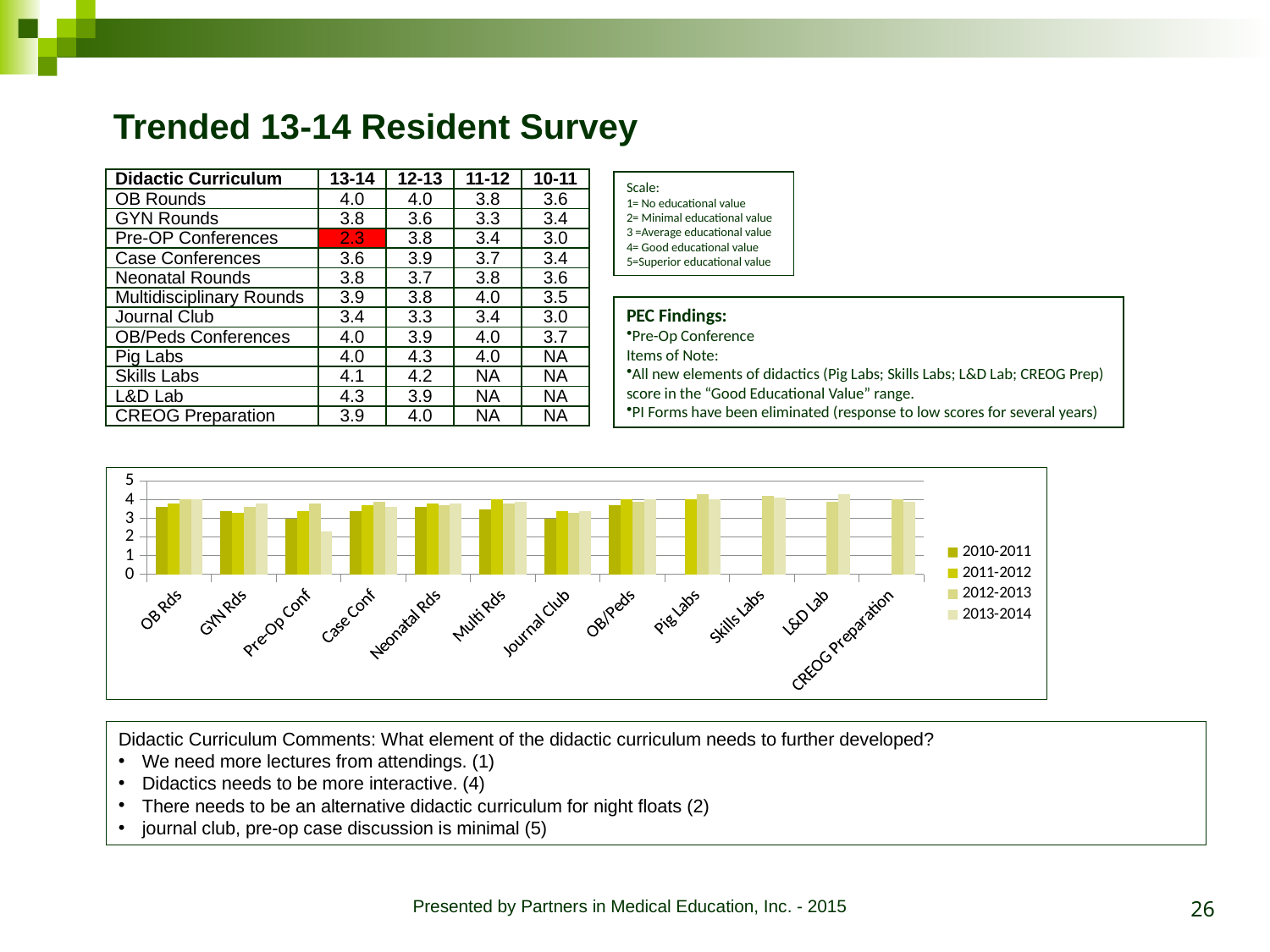
Which series are missing bars for Skills Labs, L&D Lab and CREOG Preparation? 2010-2011 and 2011-2012 What is the 2012-2013 value for Pig Labs (as printed in the table under 12-13)? 4.3 How many categories are shown along the x axis of the chart? 12 What is the 2013-2014 value for Pre-Op Conf (as printed in the table under 13-14)? 2.3 What kind of chart is shown on the slide? bar chart For Pre-Op Conf, which is larger: the 2012-2013 value or the 2013-2014 value? 2012-2013 Is the 2013-2014 value for L&D Lab greater or less than 4? greater Is the 2013-2014 value for Pre-Op Conf greater or less than 3? less Which category has the highest 2013-2014 value in the chart? L&D Lab What is the difference between the 2012-2013 and 2013-2014 values for Pre-Op Conf, using the table values? 1.5 How many series does the chart legend list? 4 Which category has the lowest 2013-2014 value in the chart? Pre-Op Conf